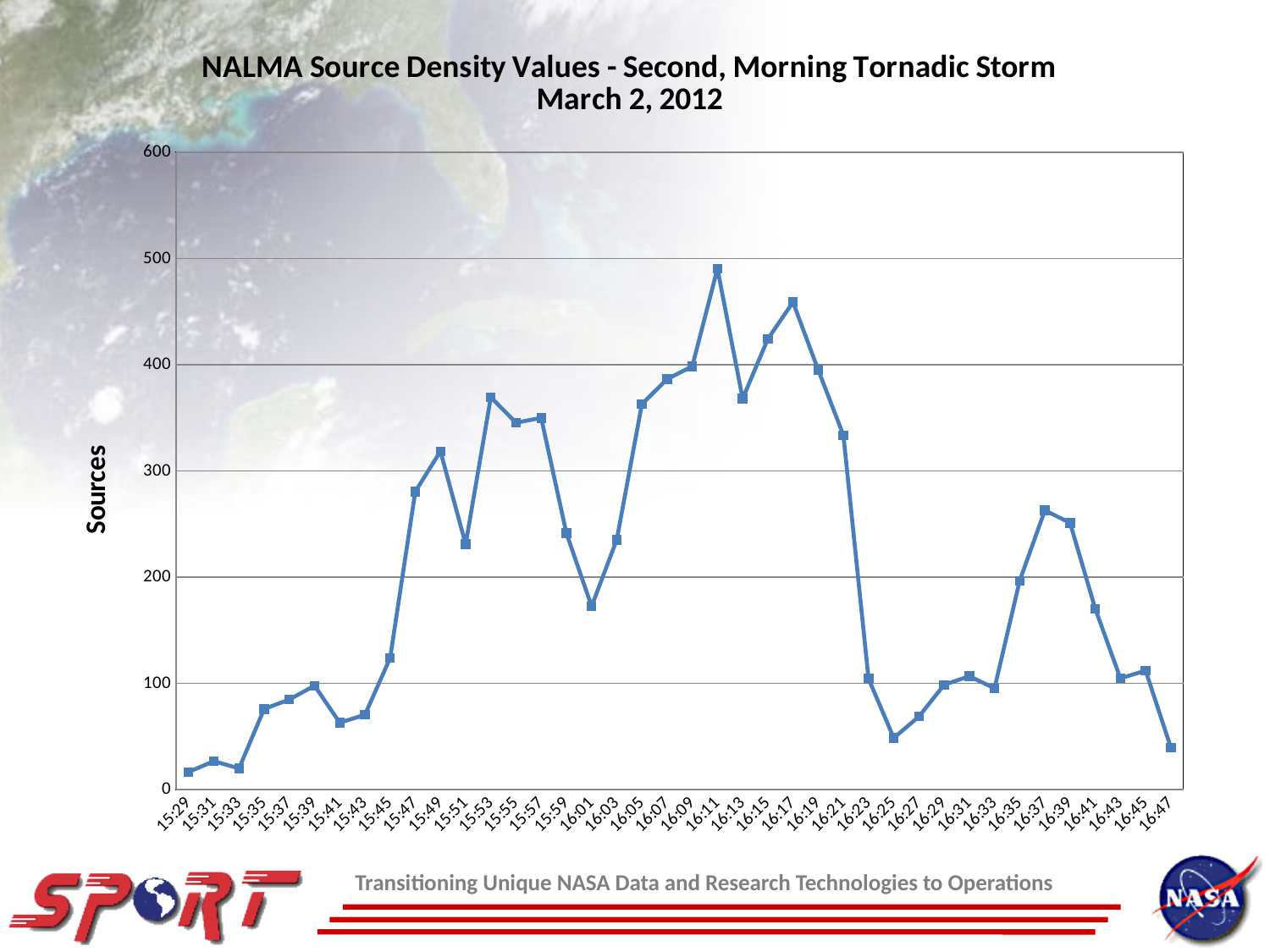
How many time points are plotted along the x axis? 40 What kind of chart is shown on the slide? line chart What is the title of the chart? NALMA Source Density Values - Second, Morning Tornadic Storm March 2, 2012 Is the value at 16:25 greater or less than 100? less Is the value at 16:01 greater or less than 200? less At which time does the line reach its highest value? 16:11 Is the value at 16:11 greater or less than 400? greater Which is larger, the value at 16:11 or the value at 16:17? 16:11 Do the values rise or fall between 16:21 and 16:25? fall What is the label on the vertical axis? Sources Which is larger, the value at 15:49 or the value at 15:51? 15:49